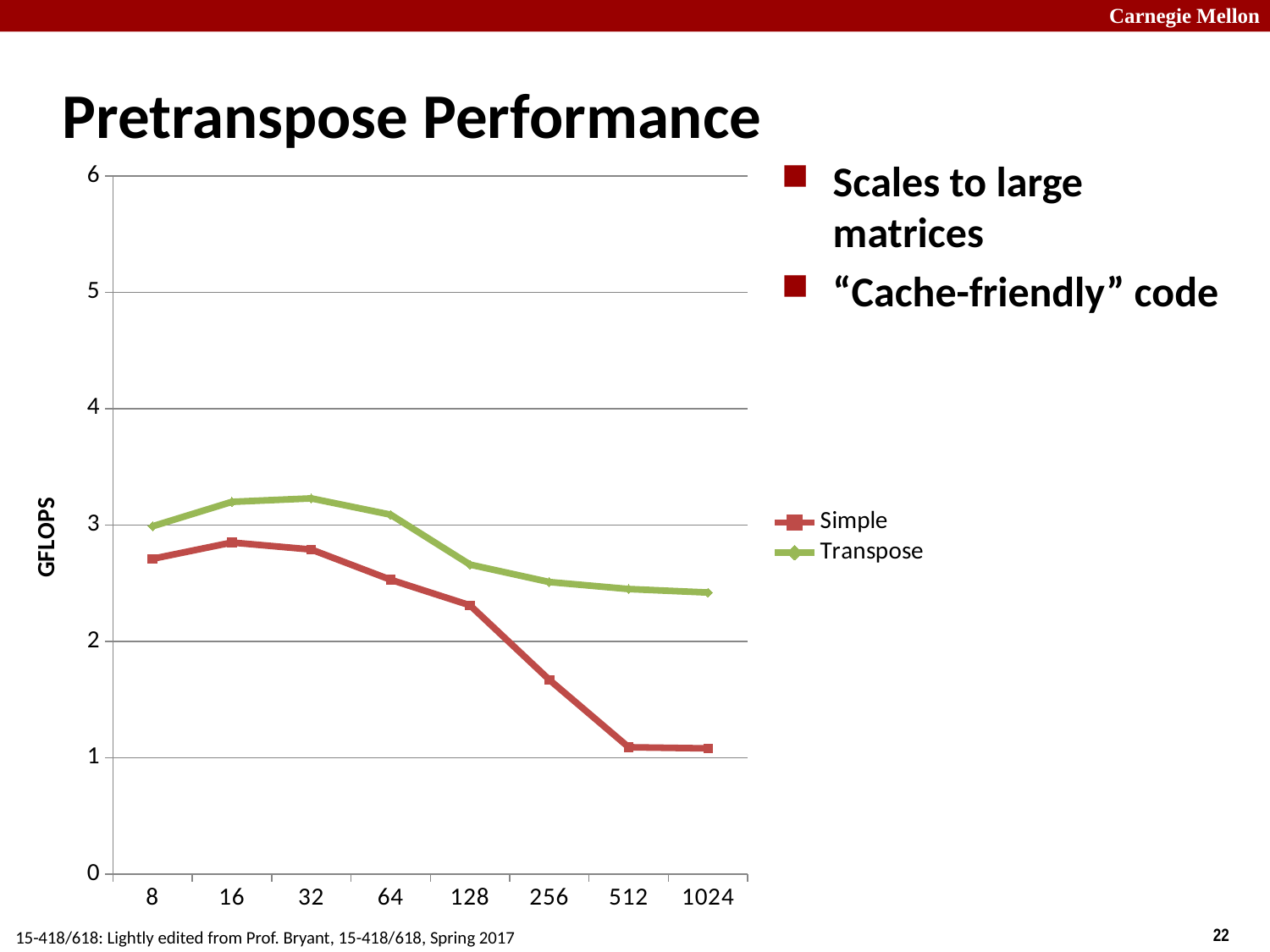
Is the value for Simple at 8 greater or less than 3? less What kind of chart is shown on the slide? line chart Is the value for Transpose at 1024 greater or less than 2? greater How many points are plotted along the x axis for each series? 8 How many series does the legend list? 2 Is the value for Simple at 512 greater or less than 2? less Do the values for Simple rise or fall from 32 to 512? fall What is the label on the y axis? GFLOPS What is the title of the chart? Pretranspose Performance At 1024, which series has the larger value, Simple or Transpose? Transpose